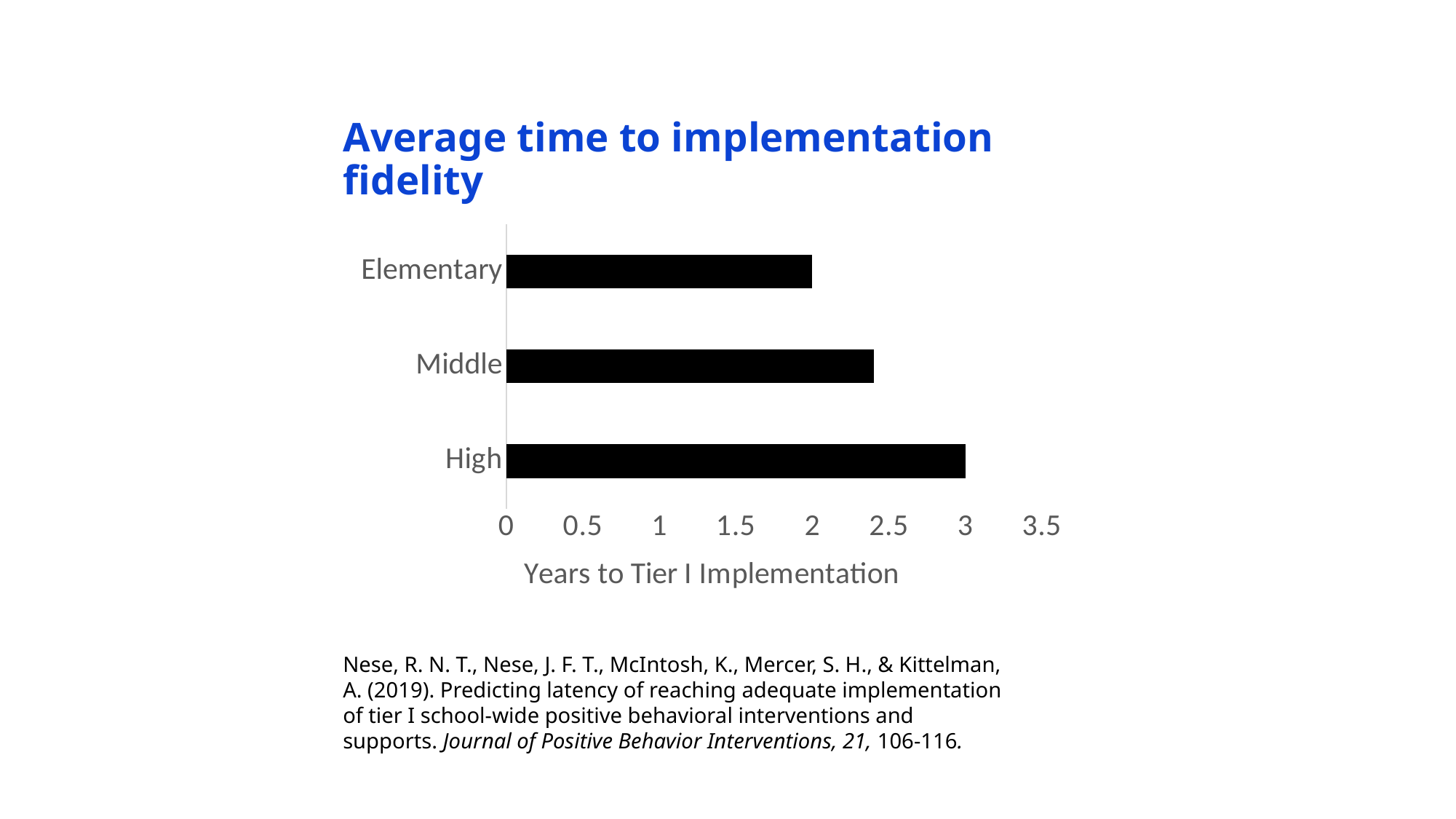
Is the value for Middle greater or less than 2.5? less How many years to Tier I implementation does the High bar show? 3 How many years to Tier I implementation does the Elementary bar show? 2 Which school level has the longest average time to implementation fidelity? High Which has a larger value, Middle or Elementary? Middle What is the difference in years between the High and Elementary bars? 1 What is the label on the horizontal axis of the chart? Years to Tier I Implementation What kind of chart is shown on the slide? bar chart How many school levels are plotted in the chart? 3 Which school level has the shortest average time to implementation fidelity? Elementary What is the title of the chart? Average time to implementation fidelity Is the value for Middle greater or less than 2? greater